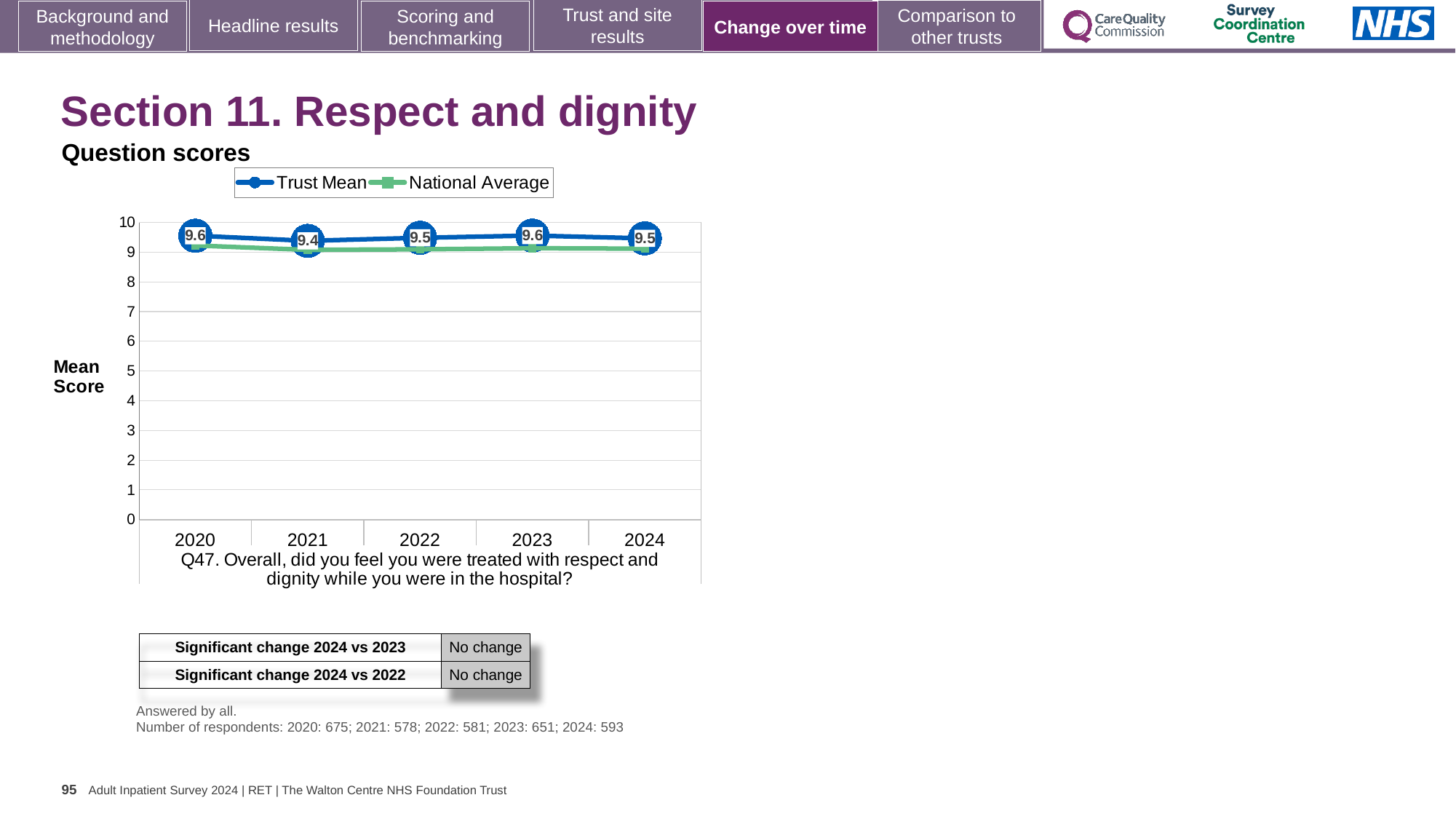
Is the National Average value for 2022 greater or less than 8? greater What is the Trust Mean value for 2020? 9.6 In which year is the Trust Mean lowest? 2021 How many years are plotted on the x axis? 5 What are the two series named in the legend? Trust Mean and National Average What is the Trust Mean value for 2024? 9.5 Which is larger, the Trust Mean in 2021 or in 2023? 2023 What kind of chart is shown? Line chart How many series does the legend list? 2 Did the Trust Mean rise or fall from 2020 to 2021? Fall What is the Trust Mean value for 2021? 9.4 What is the difference between the Trust Mean in 2020 and in 2021? 0.2